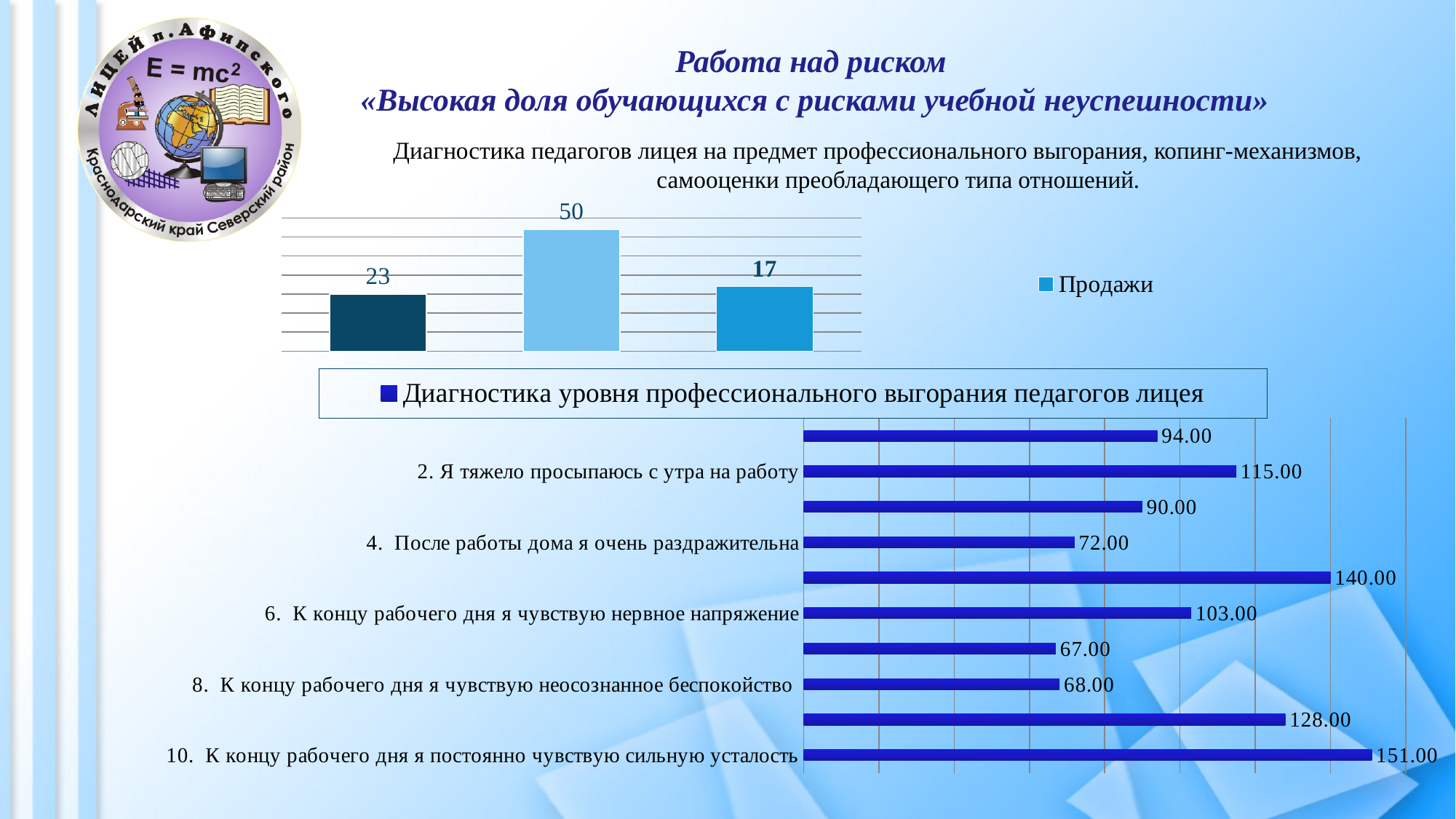
In the bottom chart 'Диагностика уровня профессионального выгорания педагогов лицея', what is the difference between the values for item 10 (151.00) and item 2 (115.00)? 36.00 How many bars are plotted in the bottom chart 'Диагностика уровня профессионального выгорания педагогов лицея'? 10 In the top chart with the legend 'Продажи', what is the lowest value shown? 17 In the bottom chart 'Диагностика уровня профессионального выгорания педагогов лицея', what is the value for '2. Я тяжело просыпаюсь с утра на работу'? 115.00 In the top chart with the legend 'Продажи', what is the difference between the highest bar (50) and the first bar (23)? 27 What kind of chart is the bottom chart 'Диагностика уровня профессионального выгорания педагогов лицея'? bar chart In the top chart with the legend 'Продажи', what is the highest value shown? 50 What kind of chart is the top chart with the legend 'Продажи'? bar chart In the bottom chart 'Диагностика уровня профессионального выгорания педагогов лицея', what is the value for '10. К концу рабочего дня я постоянно чувствую сильную усталость'? 151.00 In the bottom chart 'Диагностика уровня профессионального выгорания педагогов лицея', which is larger: the value for '6. К концу рабочего дня я чувствую нервное напряжение' or for '4. После работы дома я очень раздражительна'? 6. К концу рабочего дня я чувствую нервное напряжение How many bars are plotted in the top chart with the legend 'Продажи'? 3 In the bottom chart 'Диагностика уровня профессионального выгорания педагогов лицея', what is the value for '8. К концу рабочего дня я чувствую неосознанное беспокойство'? 68.00